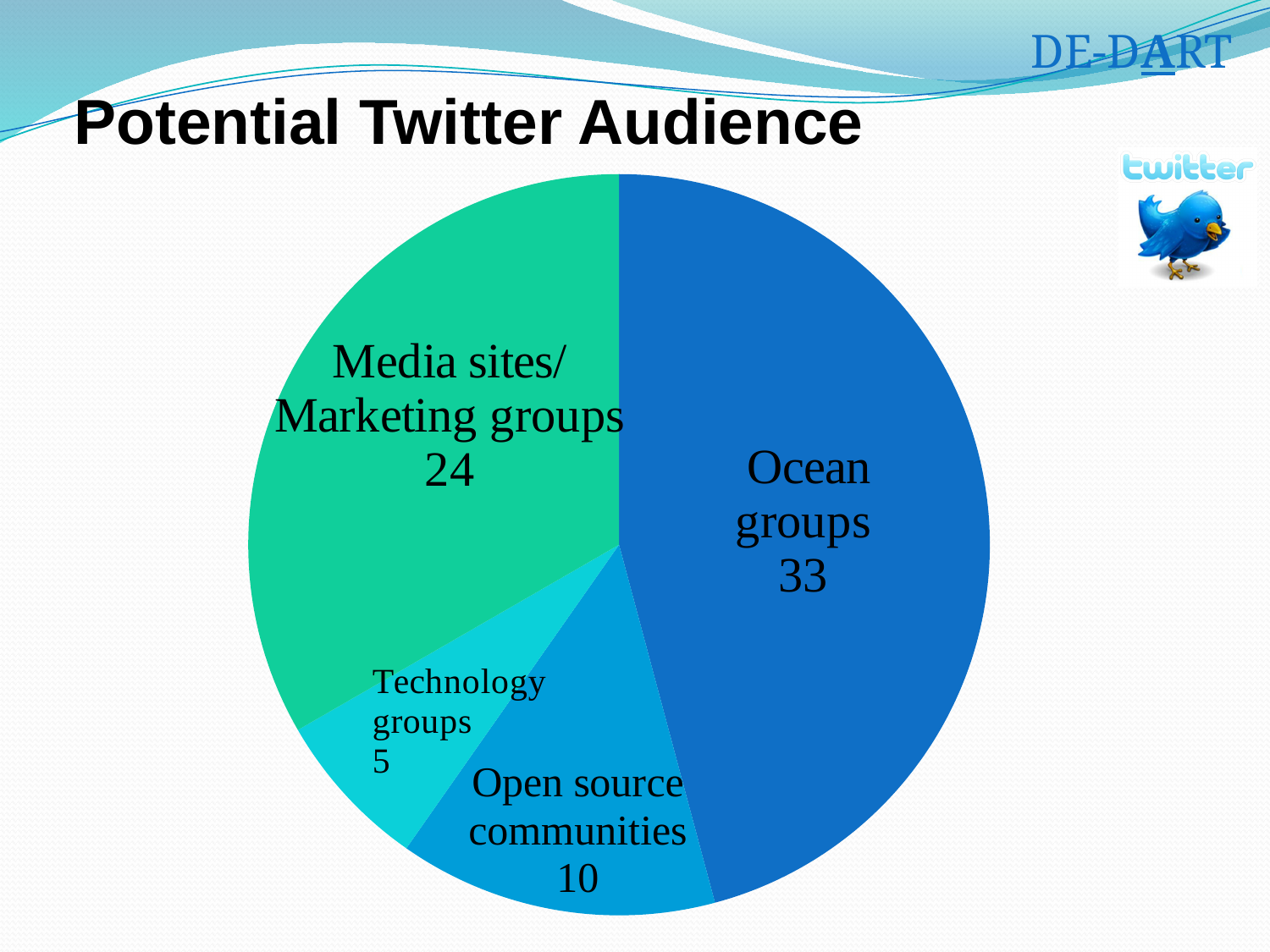
Which category has the smallest slice of the pie? Technology groups How many categories are shown in the pie chart? 4 What is the value for Technology groups? 5 What is the total of all the slice values in the pie chart? 72 Which is larger, Open source communities or Technology groups? Open source communities What is the value for Ocean groups? 33 What is the value for Media sites/Marketing groups? 24 What is the value for Open source communities? 10 Which category has the largest slice of the pie? Ocean groups What is the title of the slide containing the pie chart? Potential Twitter Audience What is the difference between the values for Ocean groups and Media sites/Marketing groups? 9 What type of chart is shown on the slide? Pie chart